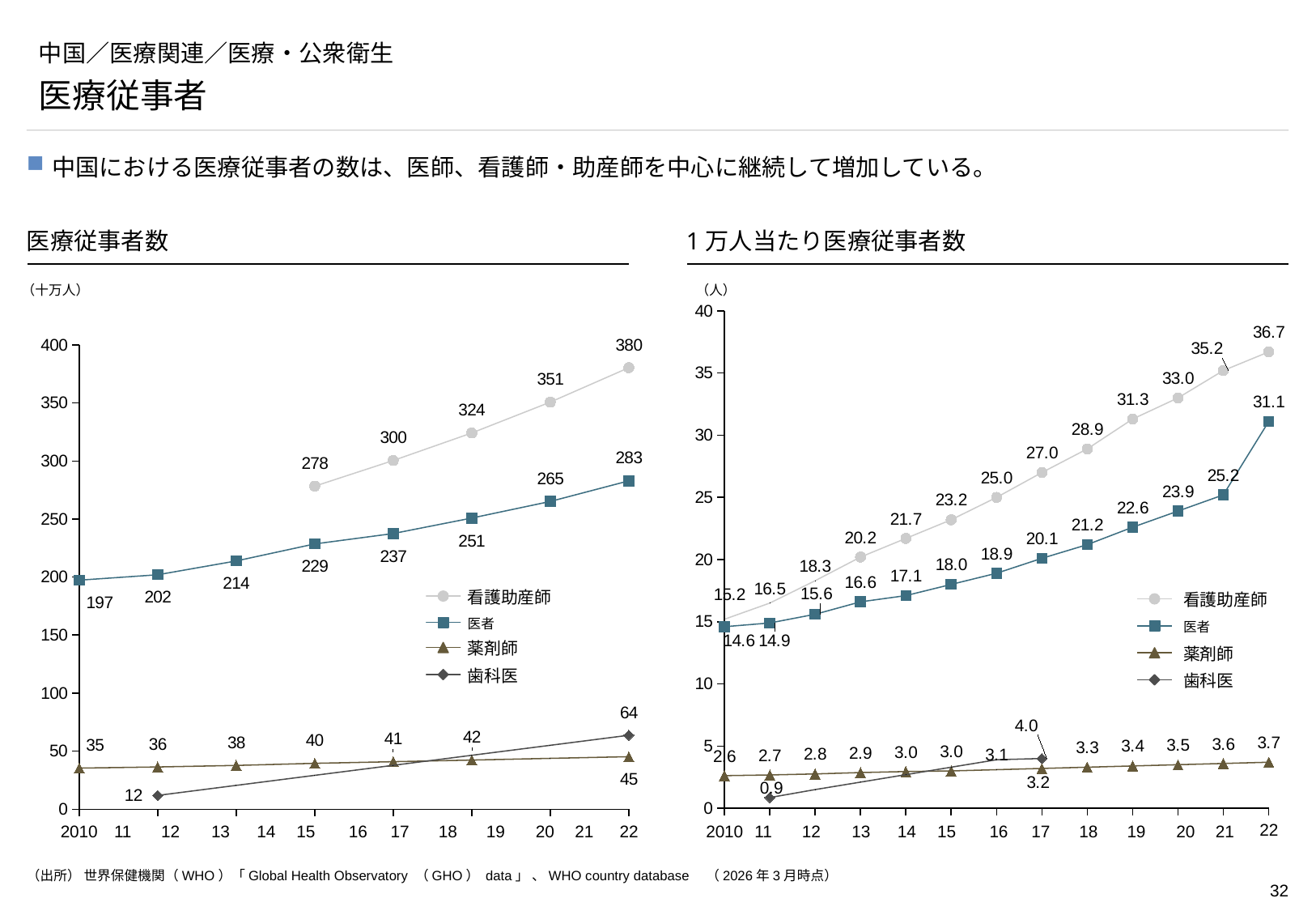
In the right chart (1万人当たり医療従事者数), which is larger in 2022: 薬剤師 or 医者? 医者 In the left chart (医療従事者数), what is the value for 医者 in 2010? 197 What type of chart is the left chart (医療従事者数)? line chart In the right chart (1万人当たり医療従事者数), what is the value for 医者 in 2010? 14.6 In the left chart (医療従事者数), which series has the highest value in 2022? 看護助産師 In the left chart (医療従事者数), how many series does the legend list? 4 In the left chart (医療従事者数), by how much did 医者 increase from 2010 (197) to 2022 (283)? 86 In the right chart (1万人当たり医療従事者数), does the value for 看護助産師 rise or fall from 2010 to 2022? rise In the right chart (1万人当たり医療従事者数), what is the value for 歯科医 in 2017? 4.0 In the left chart (医療従事者数), what is the value for 看護助産師 in 2022? 380 In the left chart (医療従事者数), what is the value for 歯科医 in 2022? 64 In the right chart (1万人当たり医療従事者数), what is the value for 看護助産師 in 2022? 36.7